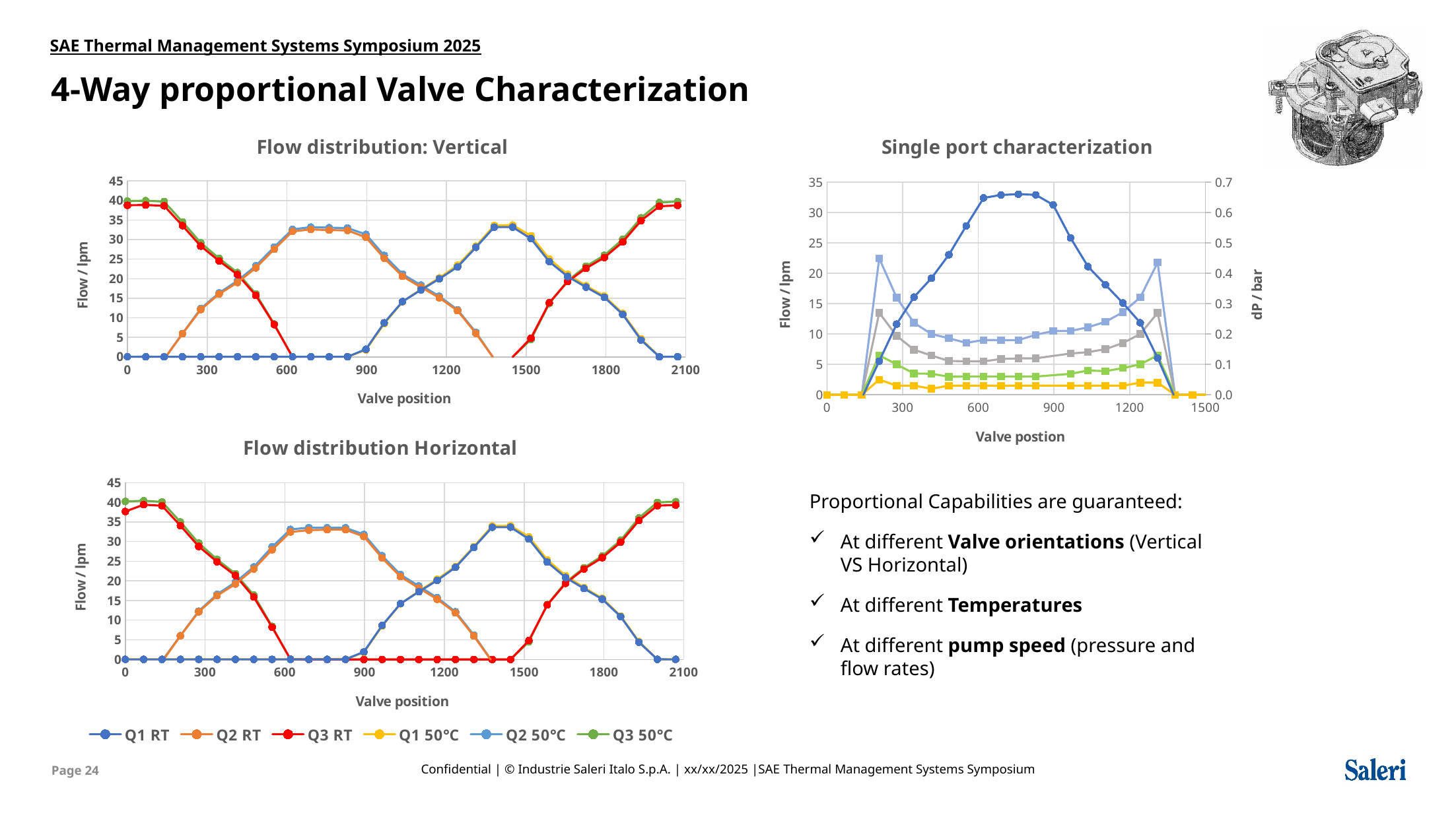
In the "Flow distribution: Vertical" chart, is the value for Q2 RT at valve position 0 greater or less than 5? less In the "Flow distribution Horizontal" chart, is the value for Q1 RT at valve position 1500 greater or less than 25? greater How many series does the legend list for the flow distribution charts? 6 What kind of chart is the "Flow distribution: Vertical" chart? line chart In the "Flow distribution: Vertical" chart, does the Q3 RT series rise or fall as valve position goes from 0 to 600? fall In the "Single port characterization" chart, is the peak value of the dark blue flow series greater or less than 30 lpm? greater In the "Flow distribution Horizontal" chart, does the Q1 RT series rise or fall as valve position goes from 900 to 1400? rise What is the label of the right-hand vertical axis in the "Single port characterization" chart? dP / bar What is the y-axis label of the "Flow distribution Horizontal" chart? Flow / lpm In the "Flow distribution: Vertical" chart, which is larger at valve position 300: Q2 RT or Q3 RT? Q3 RT In the "Flow distribution: Vertical" chart, what is the value for Q1 RT at valve position 0? 0